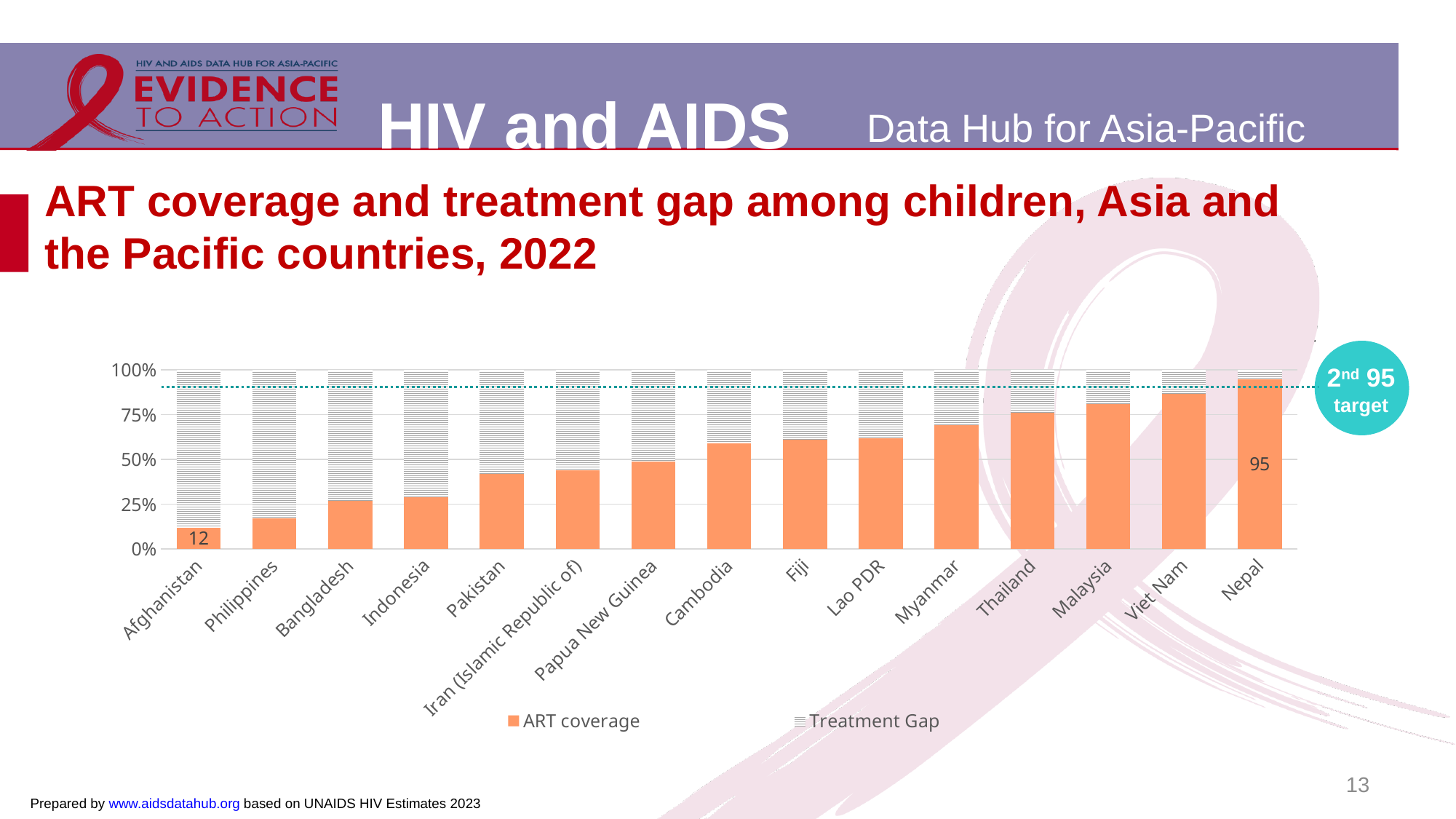
How many series does the legend list? 2 What kind of chart is shown on the slide? Stacked bar chart How many countries are shown on the x axis? 15 What is the difference between the ART coverage values labelled for Nepal and Afghanistan? 83 Is the ART coverage for Cambodia greater or less than 50%? greater What is the ART coverage value shown for Afghanistan? 12 Which country has higher ART coverage, Cambodia or Indonesia? Cambodia Which country has the lowest ART coverage? Afghanistan Is the ART coverage for Pakistan greater or less than 50%? less What is the ART coverage value shown for Nepal? 95 Which country has the highest ART coverage? Nepal Is the ART coverage for Philippines greater or less than 25%? less